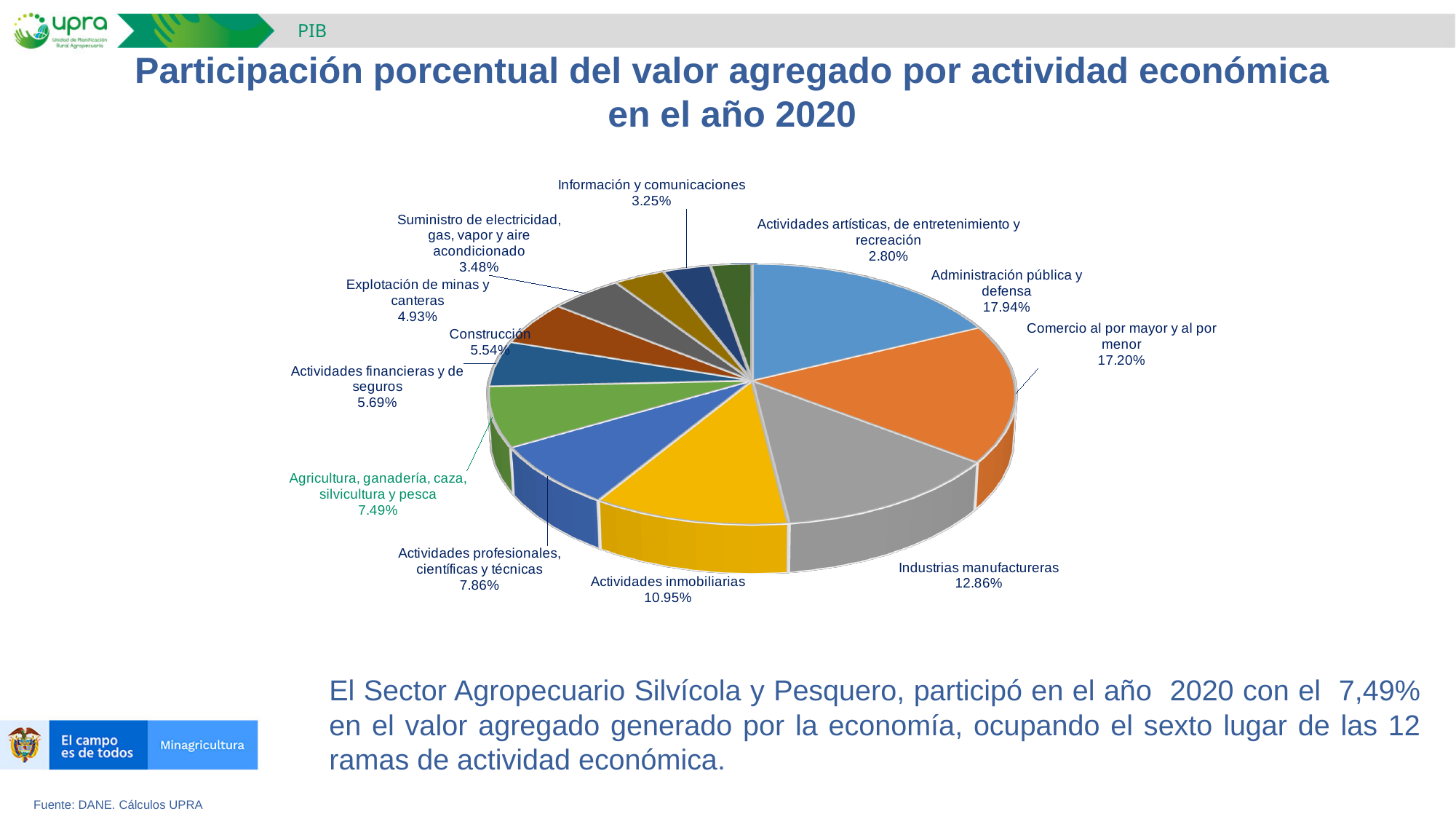
What is the value shown for Explotación de minas y canteras? 4.93% What kind of chart is shown on the slide? Pie chart How many slices (economic activities) does the pie chart contain? 12 What is the share of Administración pública y defensa in the pie chart? 17.94% Which has a larger share, Agricultura, ganadería, caza, silvicultura y pesca or Construcción? Agricultura, ganadería, caza, silvicultura y pesca What is the title of the chart on the slide? Participación porcentual del valor agregado por actividad económica en el año 2020 What percentage does the pie chart show for Agricultura, ganadería, caza, silvicultura y pesca? 7.49% What is the difference in percentage points between Industrias manufactureras and Actividades inmobiliarias? 1.91 What is the difference in percentage points between Administración pública y defensa and Comercio al por mayor y al por menor? 0.74 Which economic activity has the smallest share in the pie chart? Actividades artísticas, de entretenimiento y recreación Which economic activity has the largest share in the pie chart? Administración pública y defensa What is the value shown for Industrias manufactureras? 12.86%